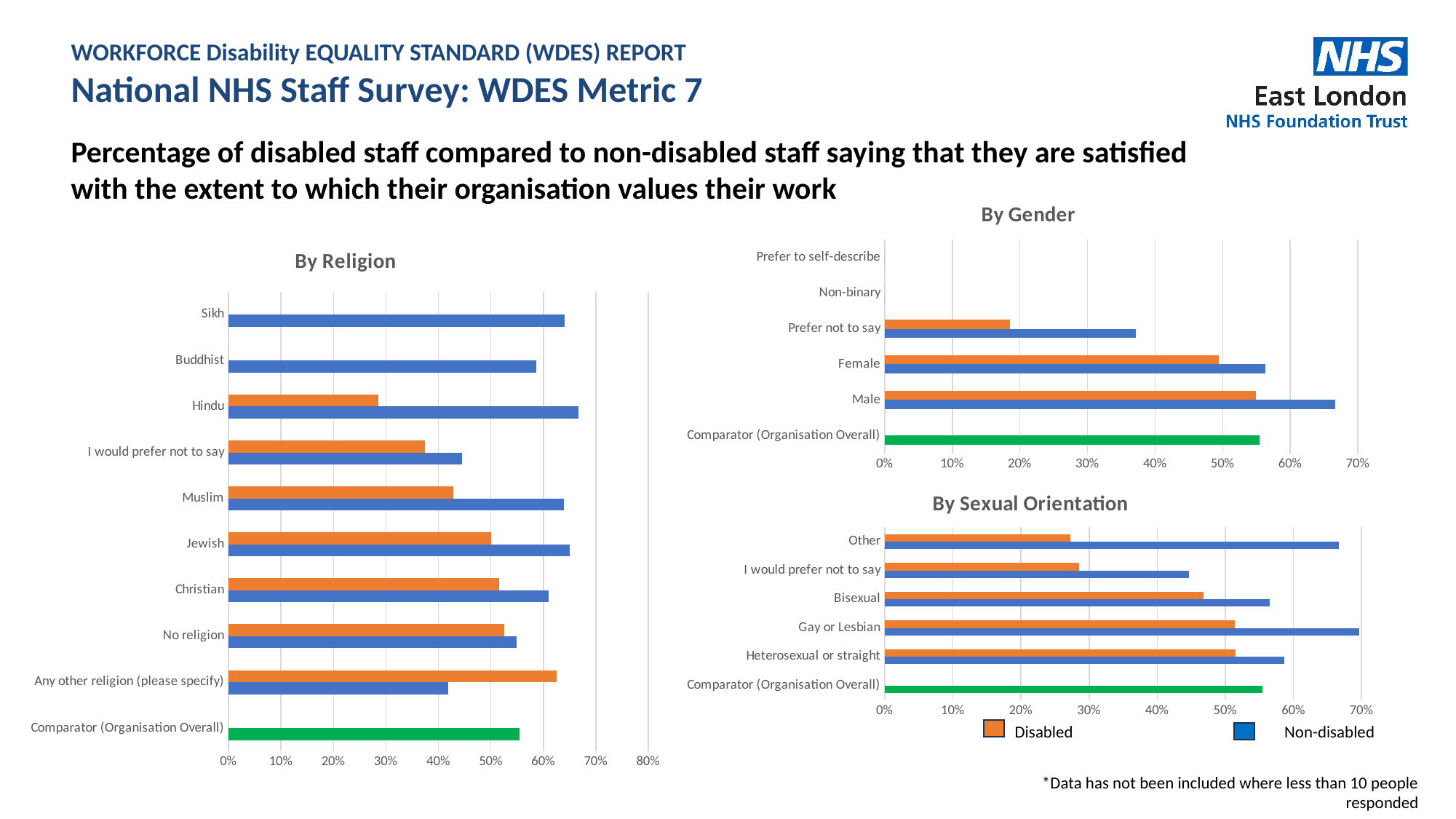
In the 'By Gender' chart, is the Disabled value for 'Prefer not to say' greater or less than 30%? less In the 'By Religion' chart, is the Non-disabled value for Muslim greater or less than 60%? greater How many categories are shown on the 'By Religion' chart, including the comparator? 10 In the 'By Religion' chart, for 'Any other religion (please specify)', which is larger: the Disabled or the Non-disabled value? Disabled In the 'By Gender' chart, for Female, which is larger: the Disabled or the Non-disabled value? Non-disabled In the 'By Gender' chart, which category has the highest Non-disabled value? Male In the 'By Sexual Orientation' chart, is the Disabled value for 'Other' greater or less than 30%? less How many series does the legend at the bottom of the slide list? 2 What type of chart is the 'By Religion' chart? bar chart